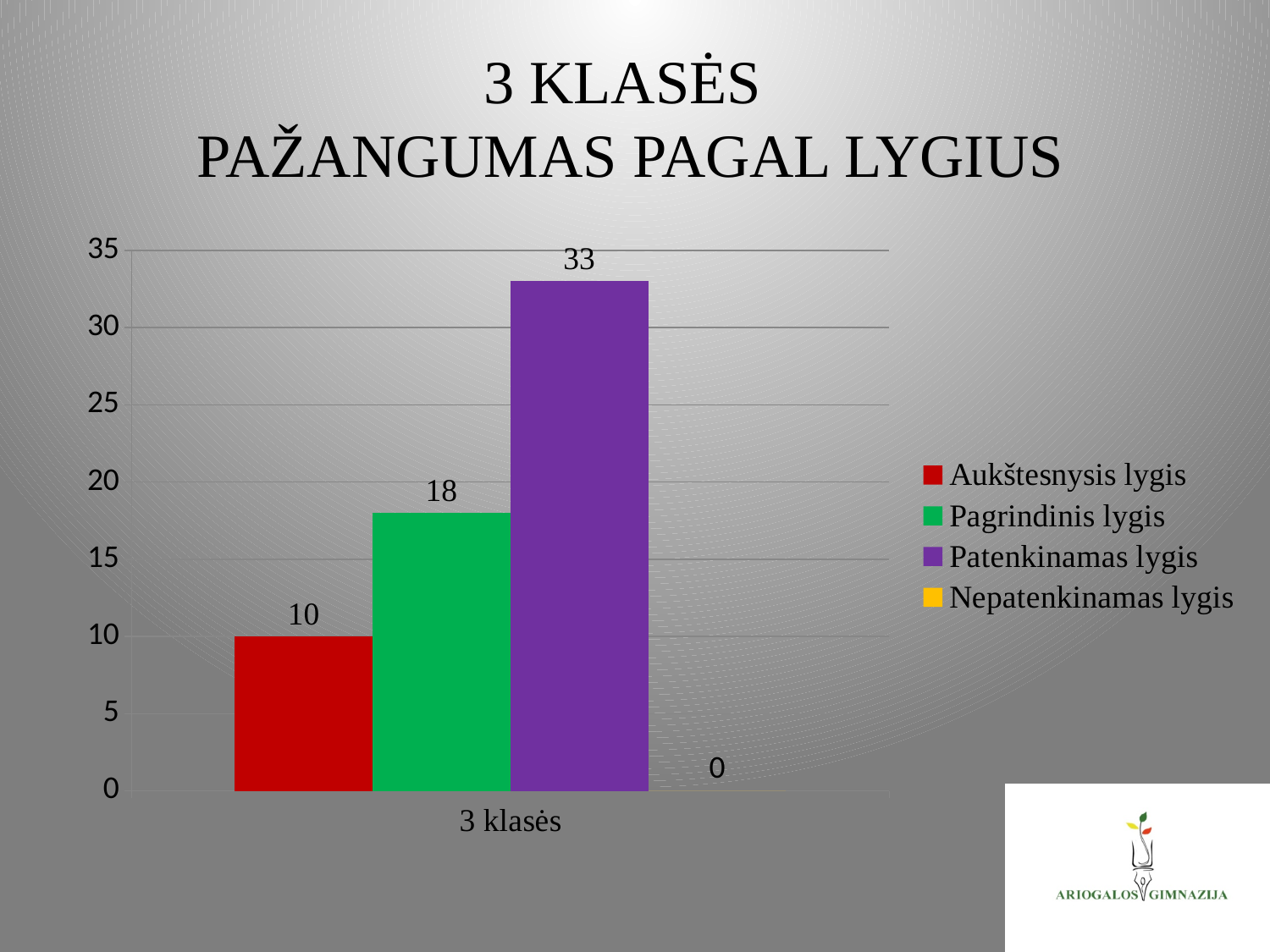
What is the value for Aukštesnysis lygis? 10 What is the category label shown on the x axis? 3 klasės What is the value for Patenkinamas lygis? 33 Which is larger, the value for Aukštesnysis lygis or the value for Pagrindinis lygis? Pagrindinis lygis Is the value for Patenkinamas lygis greater or less than 30? greater What is the value for Pagrindinis lygis? 18 How many series does the legend list? 4 What kind of chart is shown on the slide? bar chart What is the difference between the values for Patenkinamas lygis and Pagrindinis lygis? 15 What is the value for Nepatenkinamas lygis? 0 Which series has the highest value? Patenkinamas lygis Which series has the lowest value? Nepatenkinamas lygis